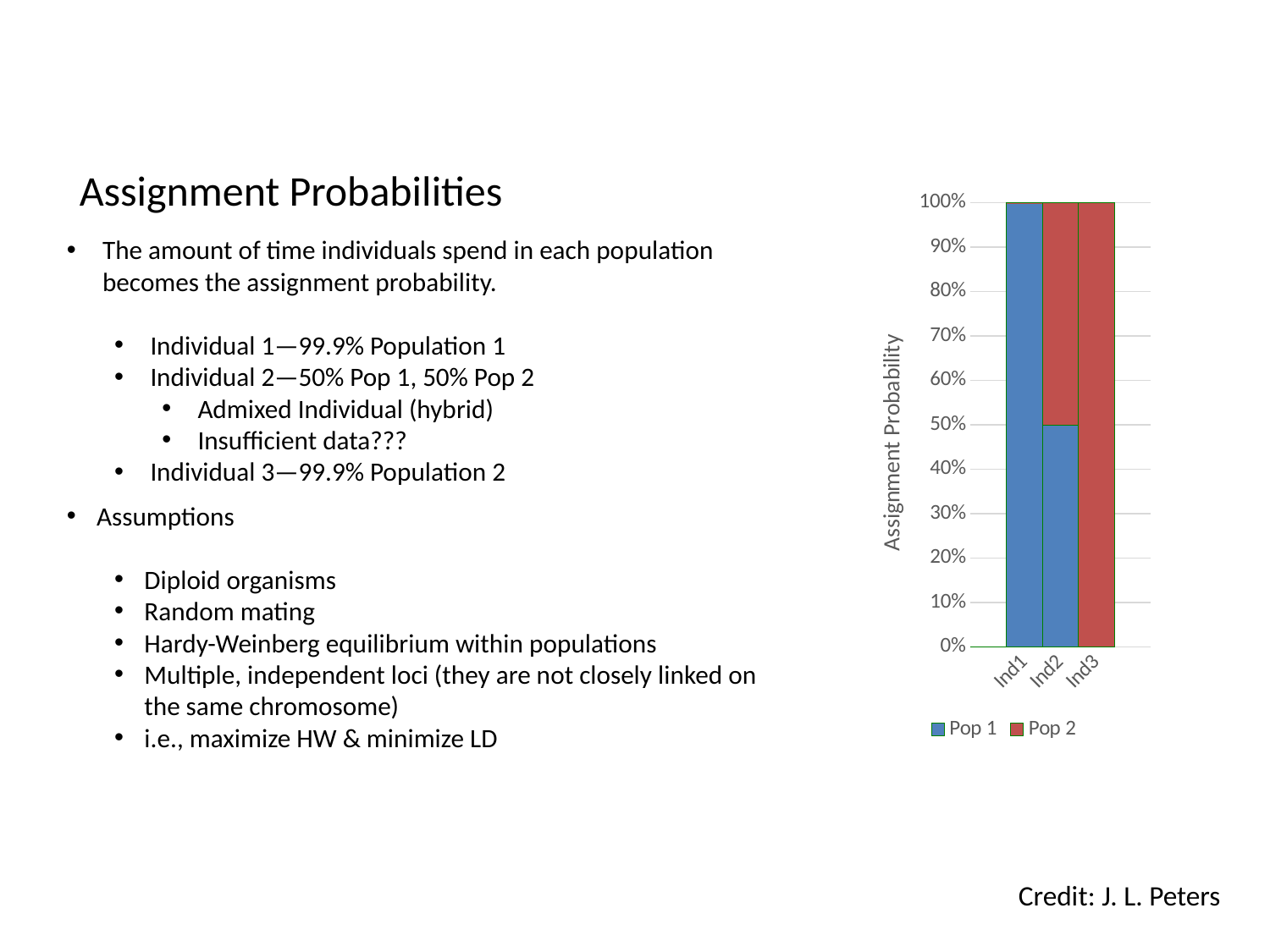
Which individual has the highest Pop 2 assignment probability? Ind3 What kind of chart is shown on the slide? Stacked bar chart How many series does the chart legend list? 2 What is the Pop 1 assignment probability for Ind2? 50% Which colour represents Pop 2 in the chart? Red Which individual has the lowest Pop 1 assignment probability? Ind3 Is the Pop 1 value for Ind1 greater or less than 90%? greater Is the Pop 2 value for Ind3 greater or less than 90%? greater How many individuals (categories) are shown on the x axis of the chart? 3 Is the Pop 1 value for Ind3 greater or less than 10%? less What is the title of the chart's vertical axis? Assignment Probability Which is larger, the Pop 1 value for Ind1 or the Pop 1 value for Ind2? Ind1